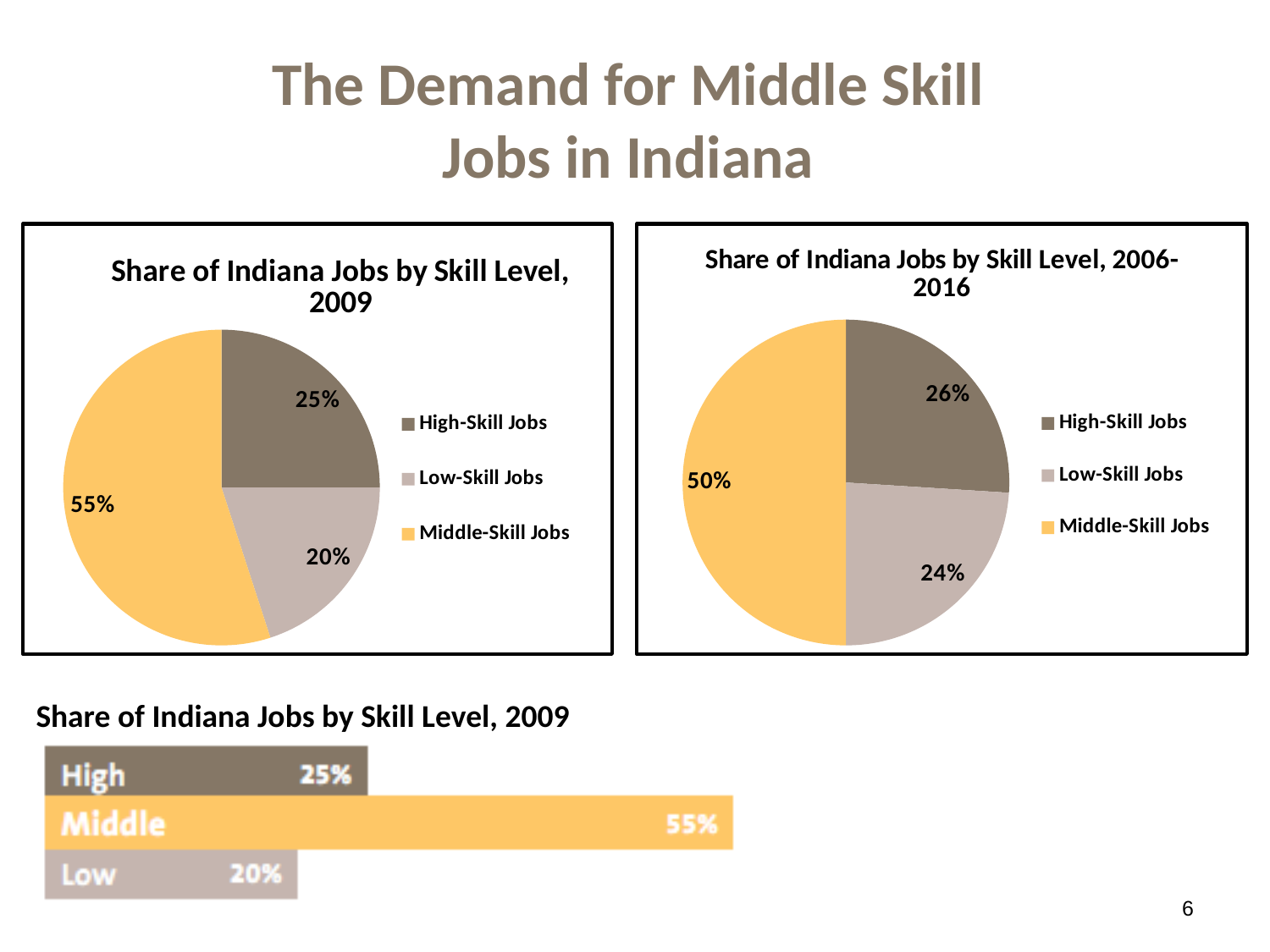
In the 'Share of Indiana Jobs by Skill Level, 2006-2016' pie chart, which is larger: High-Skill Jobs or Low-Skill Jobs? High-Skill Jobs In the 'Share of Indiana Jobs by Skill Level, 2006-2016' pie chart, what share is High-Skill Jobs? 26% In the 'Share of Indiana Jobs by Skill Level, 2009' pie chart, what is the difference between the Middle-Skill Jobs share and the High-Skill Jobs share? 30% In the bar chart at the bottom of the slide titled 'Share of Indiana Jobs by Skill Level, 2009', what is the value for Low? 20% How many categories does the 'Share of Indiana Jobs by Skill Level, 2006-2016' pie chart show? 3 What kind of chart is the 'Share of Indiana Jobs by Skill Level, 2009' chart at the top left of the slide? Pie chart In the 'Share of Indiana Jobs by Skill Level, 2006-2016' pie chart, what colour is the Middle-Skill Jobs slice? Yellow In the 'Share of Indiana Jobs by Skill Level, 2009' pie chart, what share is Low-Skill Jobs? 20% In the 'Share of Indiana Jobs by Skill Level, 2006-2016' pie chart, which category has the smallest share? Low-Skill Jobs In the 'Share of Indiana Jobs by Skill Level, 2009' pie chart, what share is Middle-Skill Jobs? 55% In the 'Share of Indiana Jobs by Skill Level, 2006-2016' pie chart, what share is Middle-Skill Jobs? 50% In the 'Share of Indiana Jobs by Skill Level, 2009' pie chart, which category has the largest share? Middle-Skill Jobs